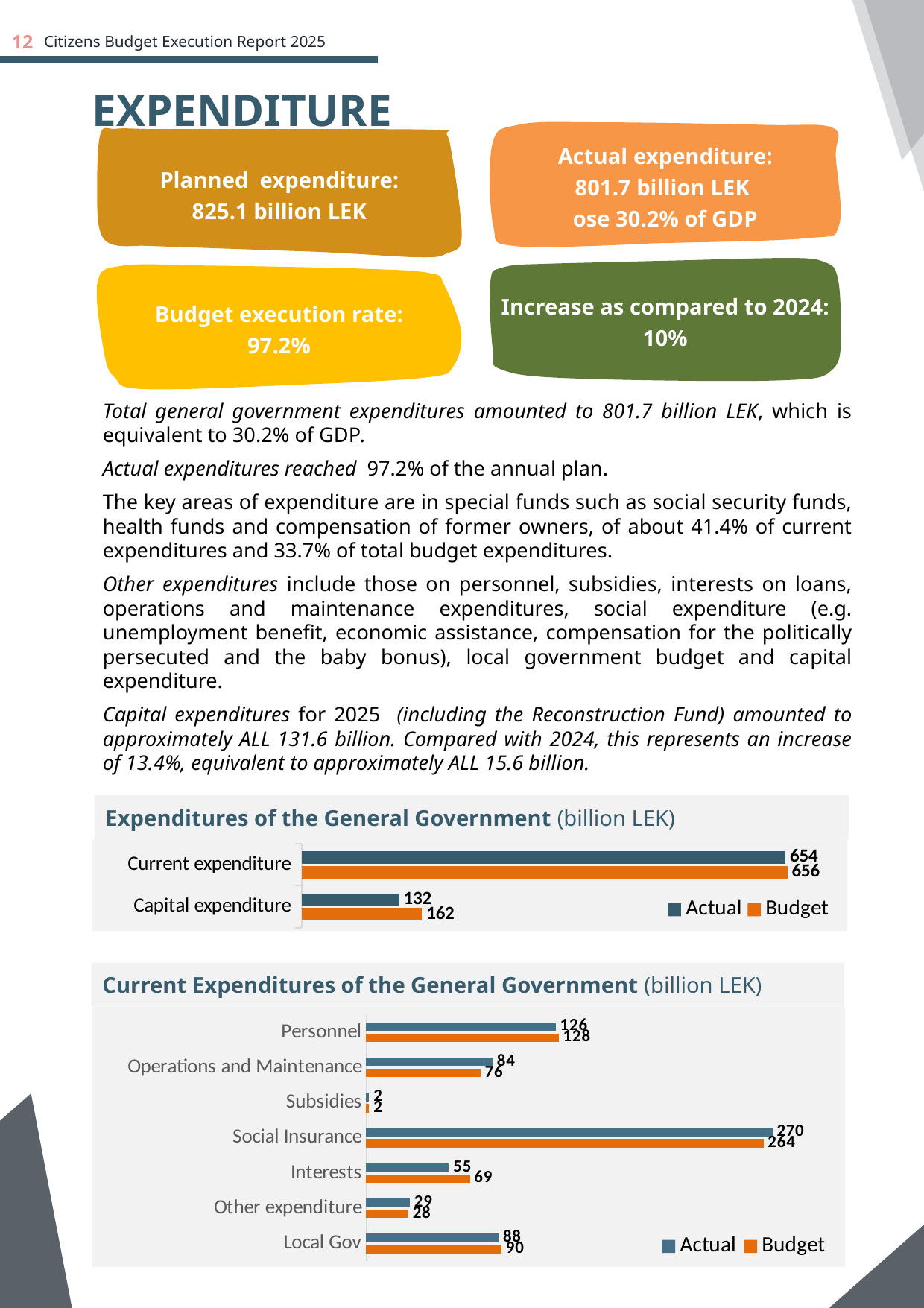
In the 'Current Expenditures of the General Government' chart, what is the difference between the Actual and Budget values for Operations and Maintenance? 8 In the 'Current Expenditures of the General Government' chart, what is the Budget value for Interests? 69 In the 'Expenditures of the General Government' chart, how many series does the legend list? 2 How many categories are shown in the 'Current Expenditures of the General Government' chart? 7 In the 'Current Expenditures of the General Government' chart, which category has the highest Actual value? Social Insurance In the 'Current Expenditures of the General Government' chart, which category has the lowest Budget value? Subsidies In the 'Expenditures of the General Government' chart, what is the Actual value for Current expenditure? 654 What type of chart is the 'Current Expenditures of the General Government' chart? Bar chart In the 'Current Expenditures of the General Government' chart, which is larger for Personnel, the Actual value or the Budget value? Budget In the 'Current Expenditures of the General Government' chart, what is the Actual value for Social Insurance? 270 In the 'Expenditures of the General Government' chart, what is the difference between the Budget and Actual values for Capital expenditure? 30 In the 'Expenditures of the General Government' chart, what is the Budget value for Capital expenditure? 162